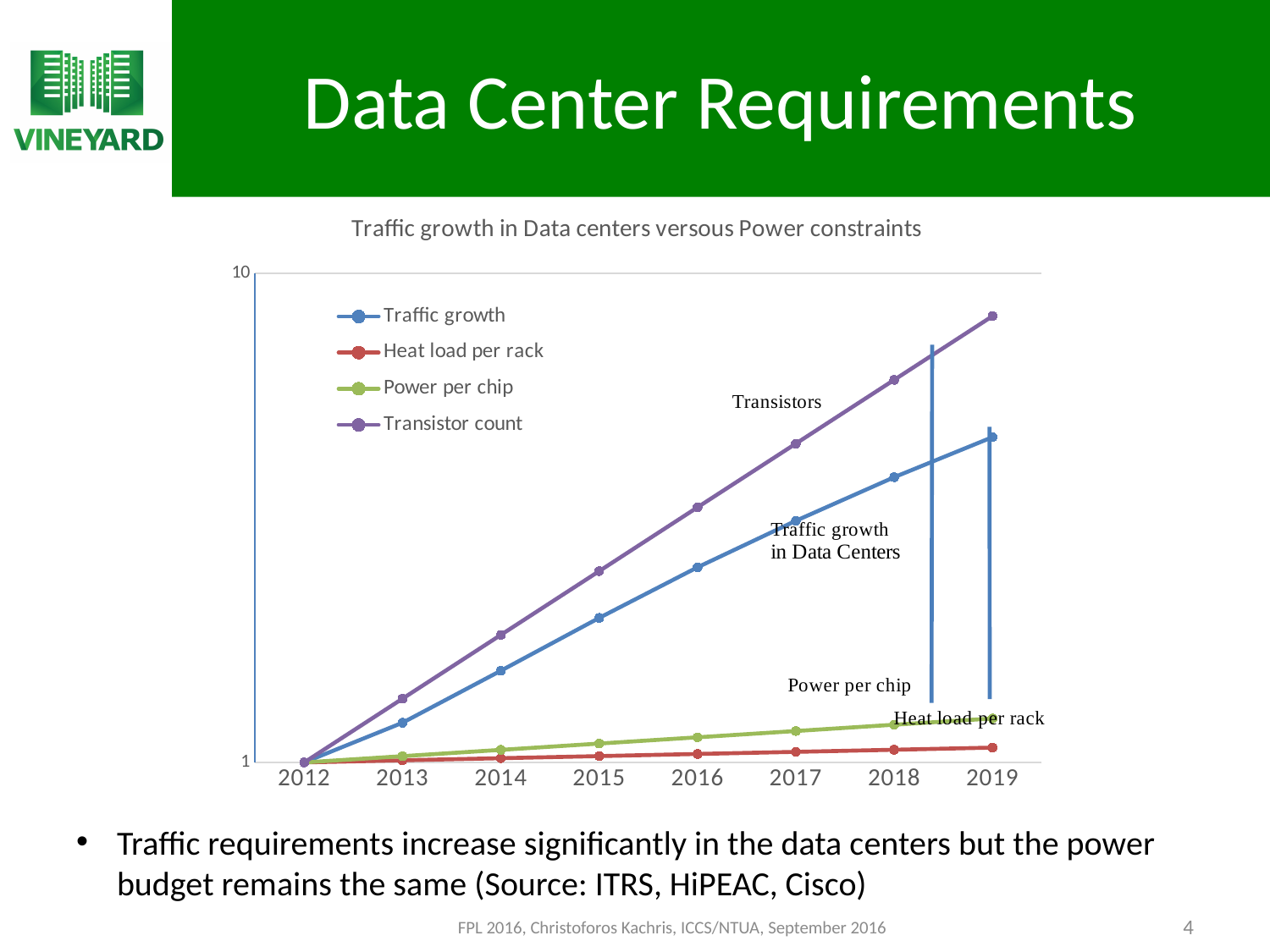
Does the Transistor count series rise or fall from 2012 to 2019? rise Which series has the lowest value in 2019? Heat load per rack What is the value of Traffic growth in 2012? 1 What is the title of the chart? Traffic growth in Data centers versous Power constraints Is the value of Traffic growth in 2019 greater or less than 1? greater Is the value of Transistor count in 2019 greater or less than 10? less How many years are shown along the x axis of the chart? 8 Which series has the highest value in 2019? Transistor count How many series does the chart legend list? 4 What colour is the Transistor count line in the chart? purple What kind of chart is shown on the slide? line chart In 2019, which is larger: Traffic growth or Power per chip? Traffic growth